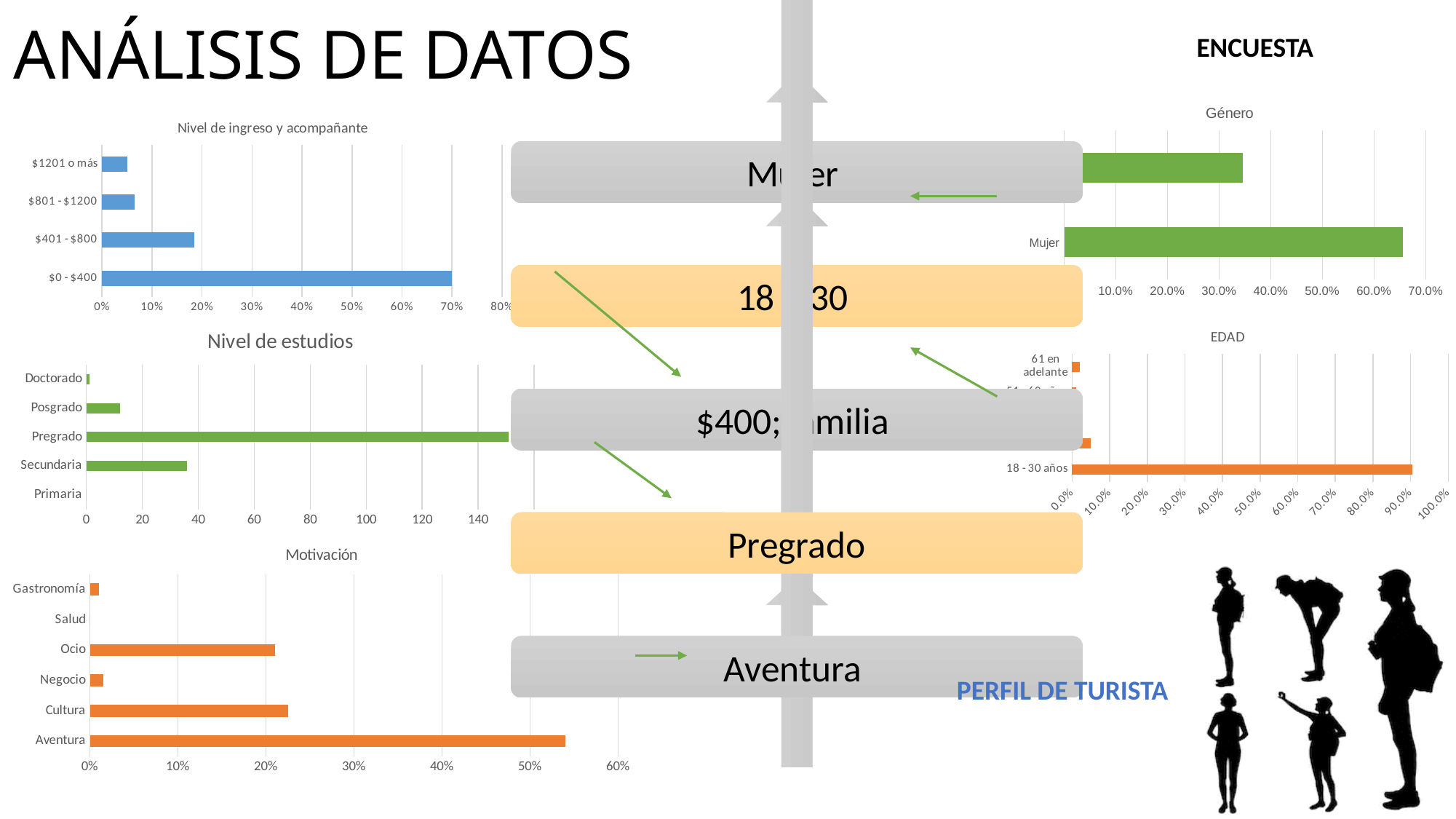
How many income categories are shown in the 'Nivel de ingreso y acompañante' chart? 4 In the 'Nivel de ingreso y acompañante' chart, is the value for $0 - $400 greater or less than 60%? greater In the 'Motivación' chart, which is larger, Cultura or Negocio? Cultura In the 'Género' chart, is the value for Mujer greater or less than 60.0%? greater In the 'Motivación' chart, which motivation has the highest value? Aventura How many education levels are listed in the 'Nivel de estudios' chart? 5 In the 'Nivel de estudios' chart, which education level has the highest value? Pregrado In the 'Nivel de ingreso y acompañante' chart, which income category has the lowest value? $1201 o más In the 'Nivel de estudios' chart, is the value for Secundaria greater or less than 20? greater What kind of chart is the 'Motivación' chart? Bar chart In the 'Nivel de ingreso y acompañante' chart, which income category has the highest value? $0 - $400